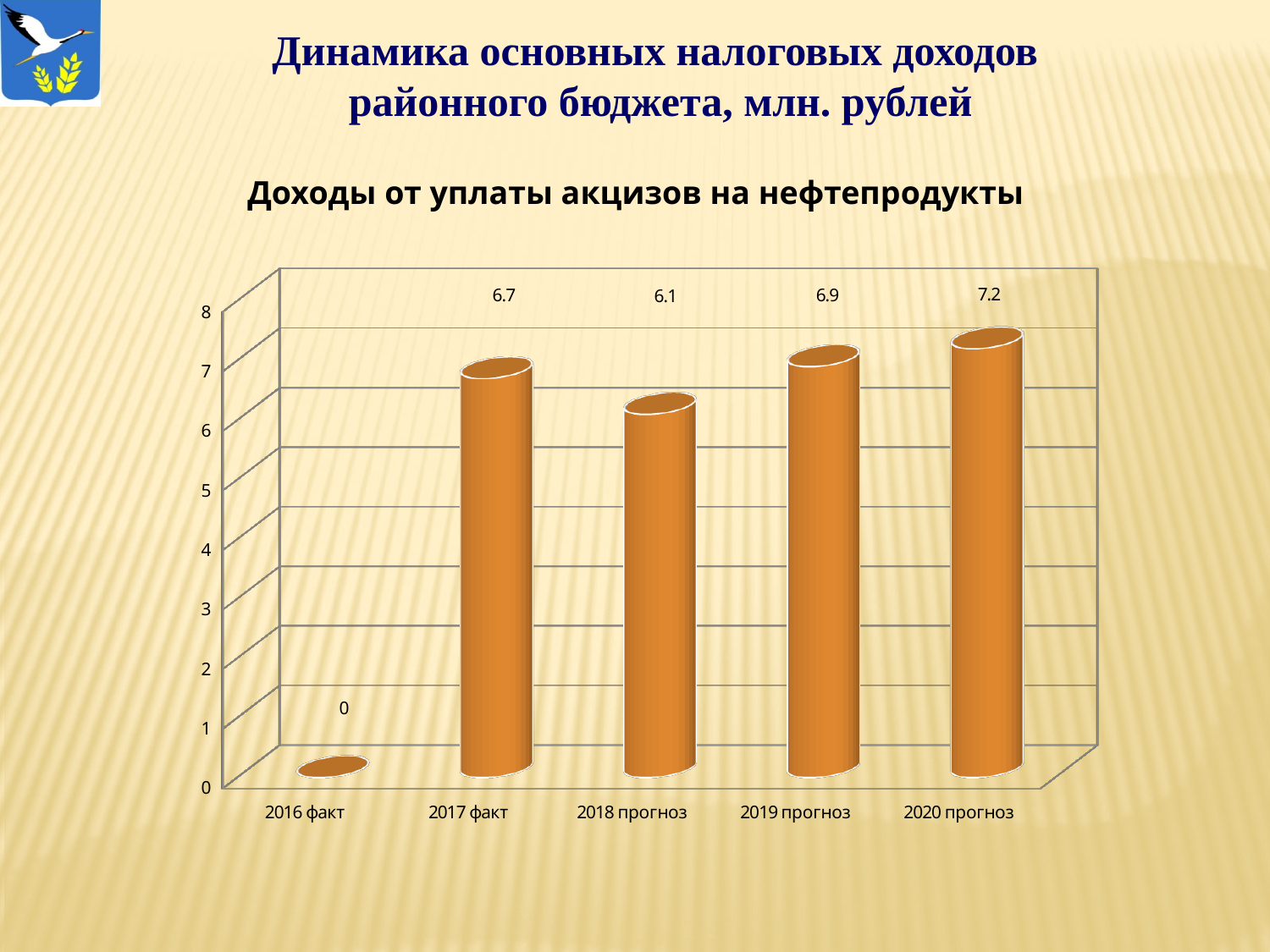
What is the value for 2020 прогноз? 7.2 What is the difference between the values for 2020 прогноз and 2018 прогноз? 1.1 What is the title of the chart? Доходы от уплаты акцизов на нефтепродукты Which category has the highest value? 2020 прогноз How many categories are shown on the x axis? 5 What kind of chart is shown on the slide? bar chart What is the value for 2017 факт? 6.7 Which category has the lowest value? 2016 факт Is the value for 2019 прогноз greater or less than 6? greater Which is larger, the value for 2017 факт or the value for 2019 прогноз? 2019 прогноз What is the value for 2016 факт? 0 What is the value for 2018 прогноз? 6.1